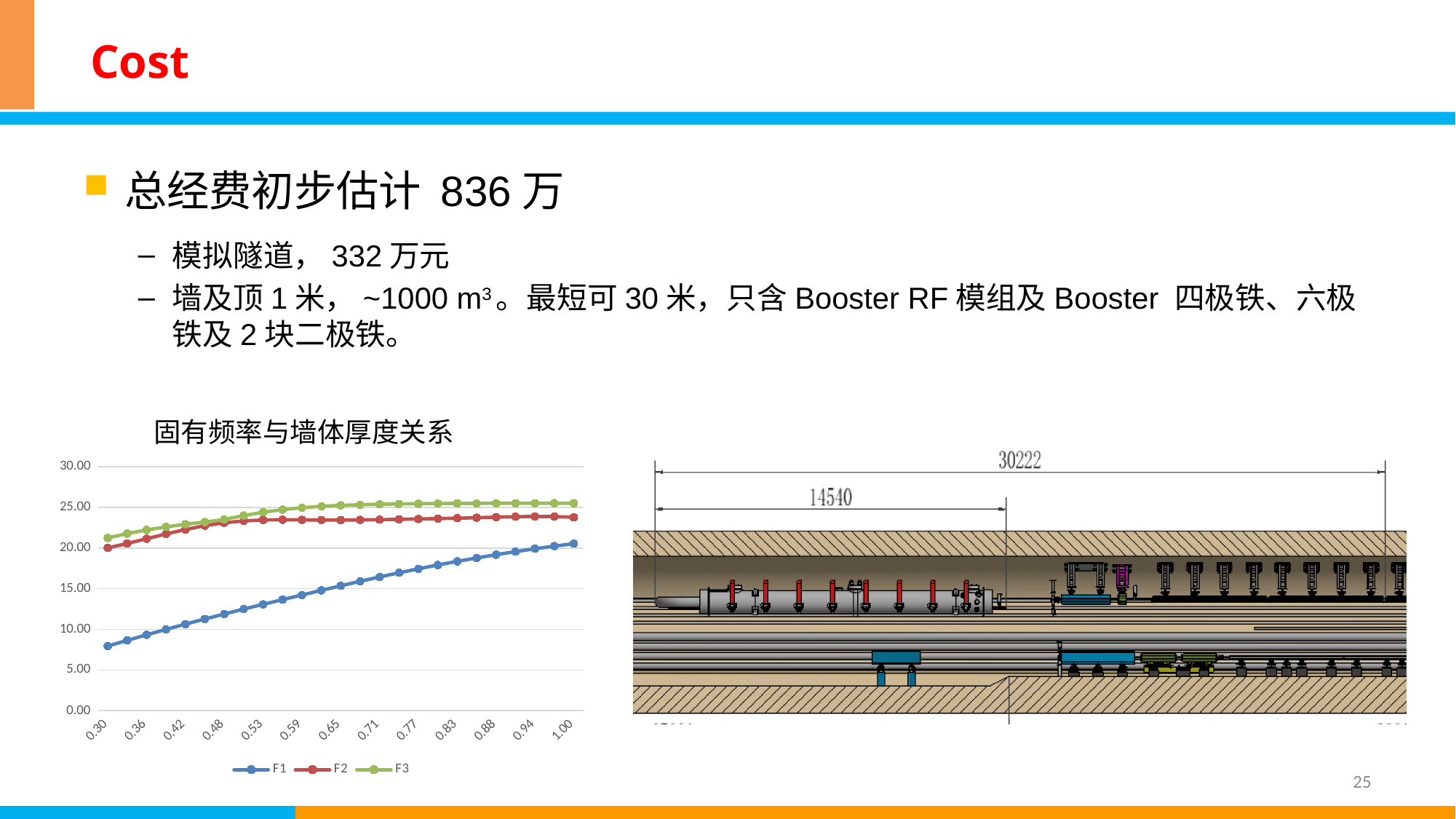
What are the names of the series in the chart's legend? F1, F2, F3 How many series does the legend of the chart list? 3 Which series has the lowest value at x = 0.30? F1 Does the F1 series rise or fall as the x-axis value increases from 0.30 to 1.00? rise Is the value of F1 at x = 0.30 greater or less than 10.00? less What kind of chart is shown under the title 固有频率与墙体厚度关系? line chart Is the value of F2 at x = 0.30 greater or less than 25.00? less Is the value of F1 at x = 1.00 greater or less than 15.00? greater Which series has the highest value at x = 1.00? F3 What is the title of the chart on the slide? 固有频率与墙体厚度关系 At x = 0.65, which series has the larger value, F1 or F3? F3